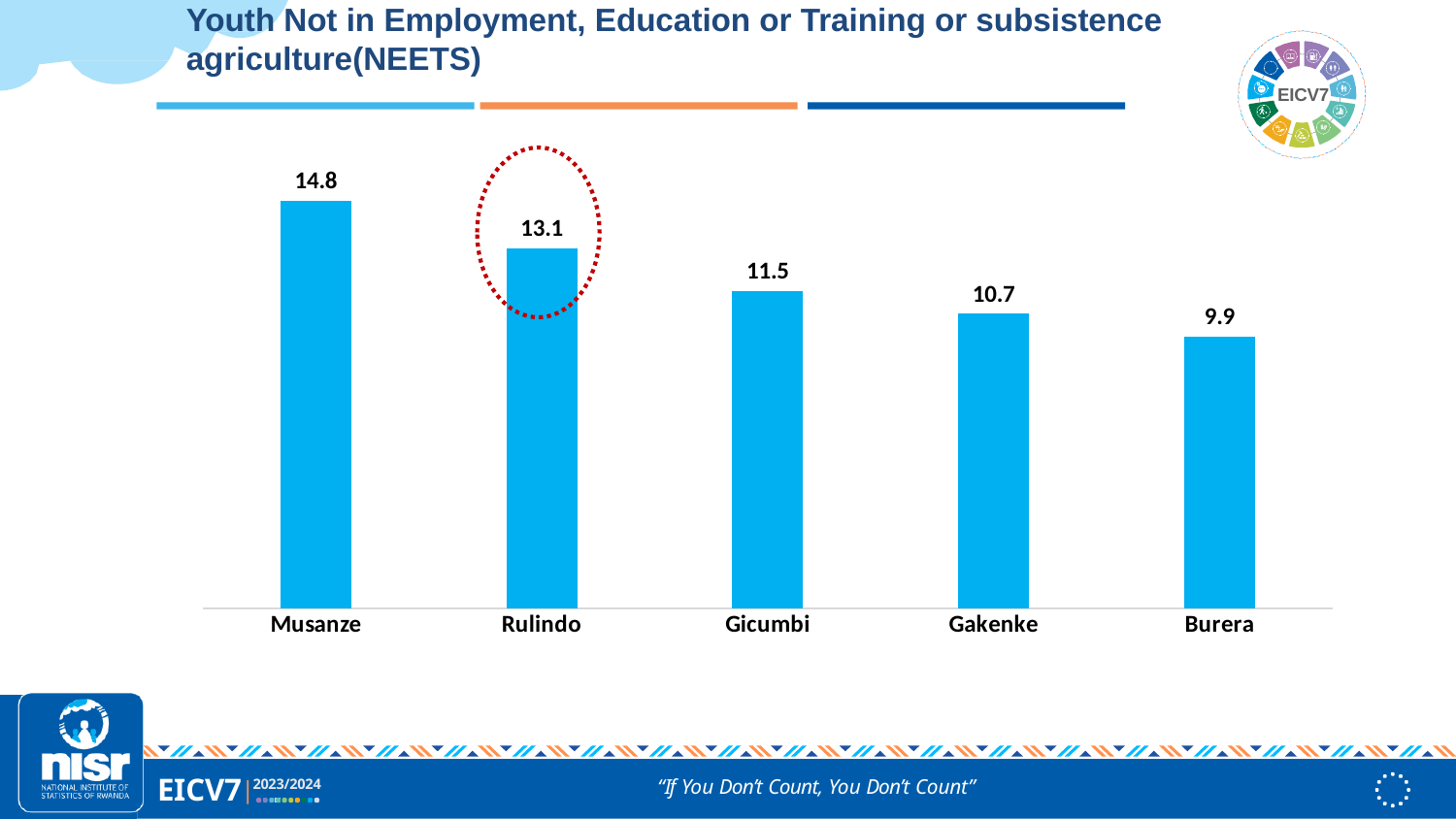
Which is larger, the value for Rulindo or the value for Gicumbi? Rulindo What is the value for Rulindo? 13.1 How many districts are shown in the chart? 5 What is the value for Gicumbi? 11.5 What is the value for Burera? 9.9 What is the value for Musanze? 14.8 Which district has the highest value? Musanze What is the value for Gakenke? 10.7 Which district's bar is highlighted with a red dotted circle? Rulindo Which district has the lowest value? Burera What kind of chart is shown on the slide? Bar chart What is the difference between the values for Musanze and Burera? 4.9